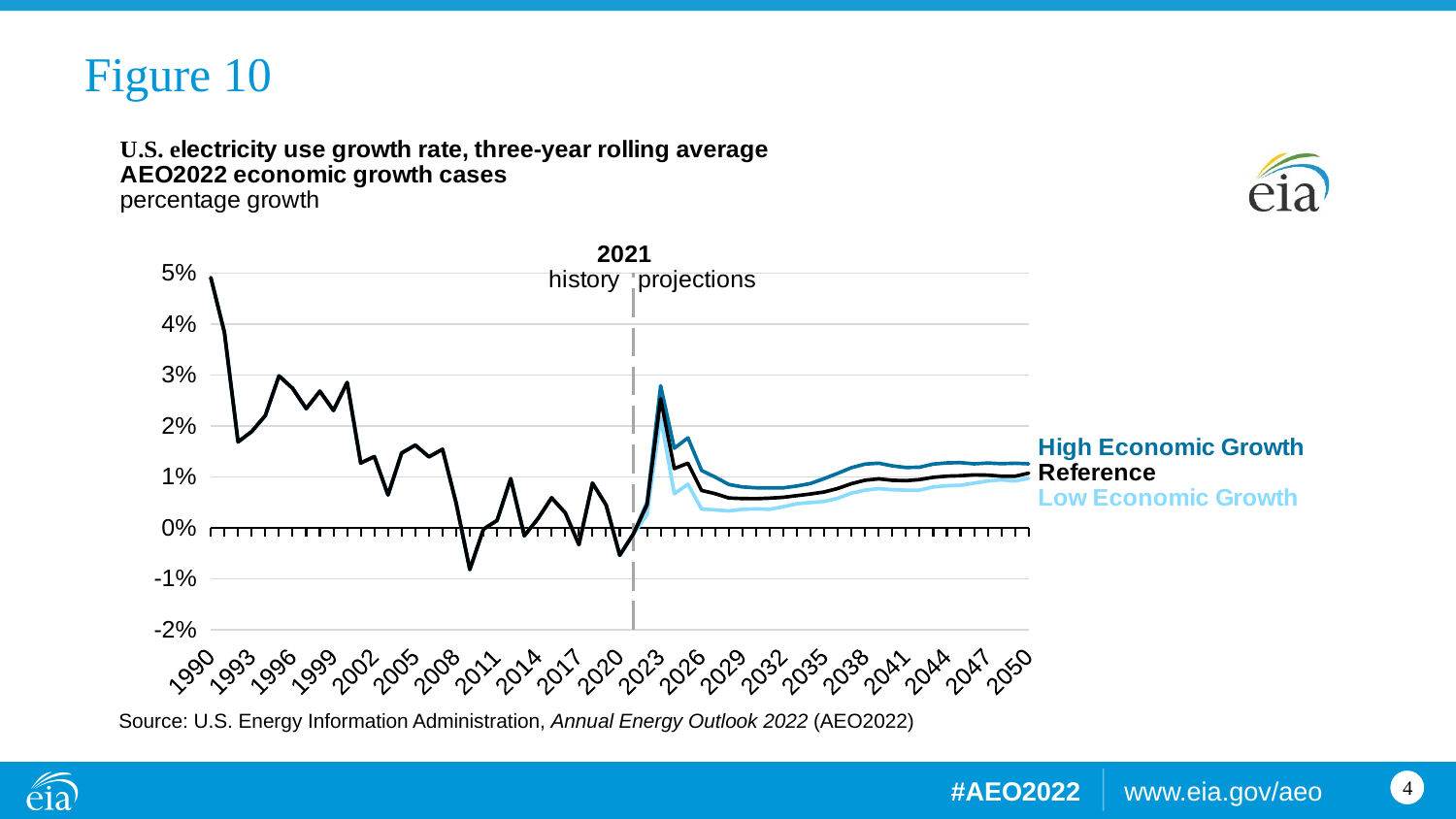
Is the lowest value in the history period (around 2010) greater or less than 0%? less Is the peak of the High Economic Growth line in the projection period greater or less than 2%? greater What is the first line of the chart's title? U.S. electricity use growth rate, three-year rolling average Which is larger in 2040, the High Economic Growth value or the Low Economic Growth value? High Economic Growth Overall, does the growth rate rise or fall from 1990 to 2020? fall Which series has the lowest value in 2050? Low Economic Growth Is the Reference value in 2050 greater or less than 2%? less How many series are labelled on the chart? 3 What year does the dashed vertical line separating history from projections mark? 2021 Which series has the highest value in 2050? High Economic Growth What kind of chart is shown on the slide? line chart